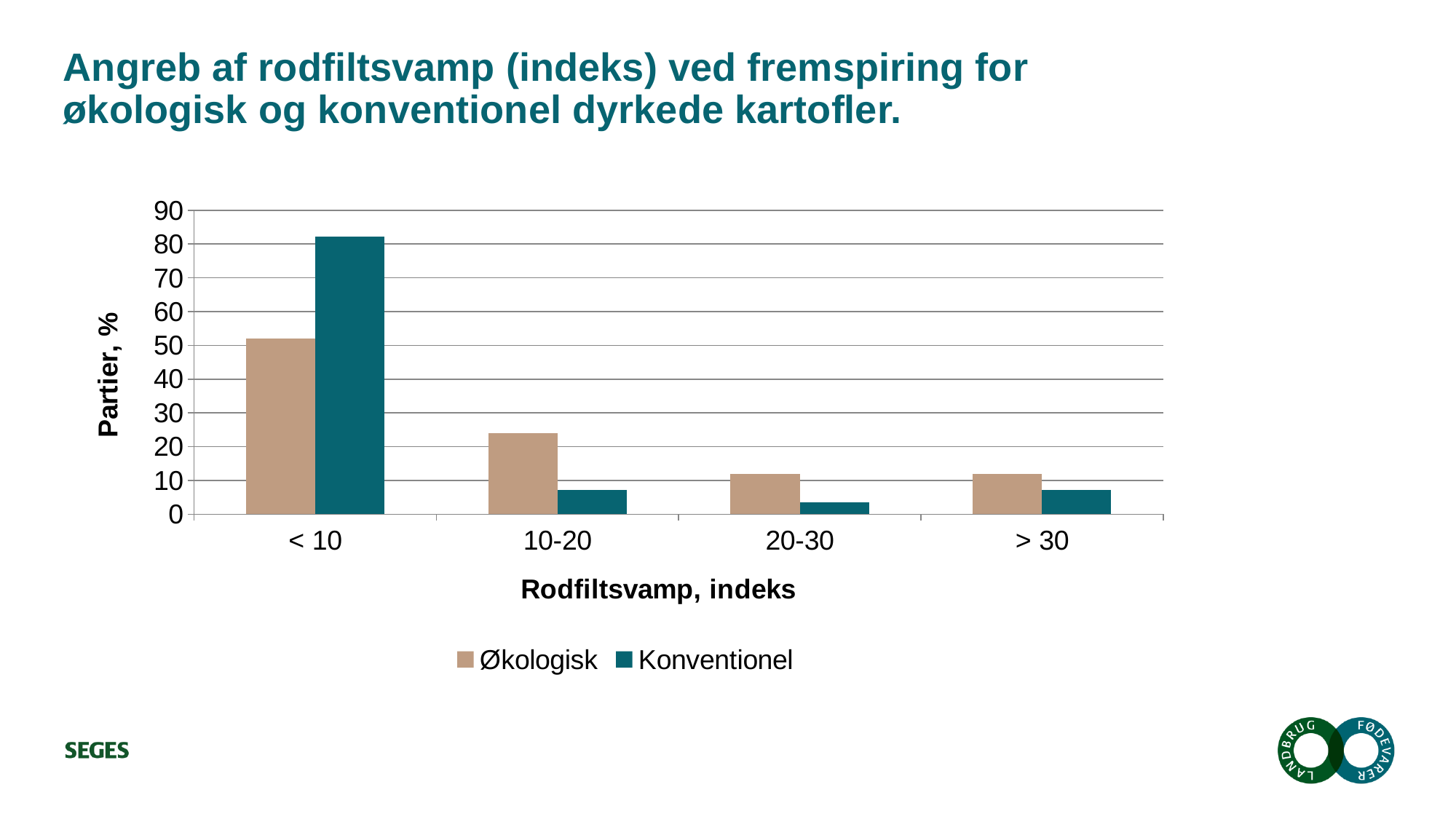
Which category has the highest value for Økologisk? < 10 Which category has the lowest value for Konventionel? 20-30 Is the value for Økologisk in the < 10 category greater or less than 50? greater How many categories are shown on the x axis? 4 What kind of chart is shown on the slide? bar chart Which is larger in the 10-20 category, Økologisk or Konventionel? Økologisk What is the label of the y axis? Partier, % Which category has the highest value for Konventionel? < 10 Which is larger in the < 10 category, Økologisk or Konventionel? Konventionel Is the value for Konventionel in the < 10 category greater or less than 80? greater How many series does the legend list? 2 Is the value for Økologisk in the 10-20 category greater or less than 20? greater